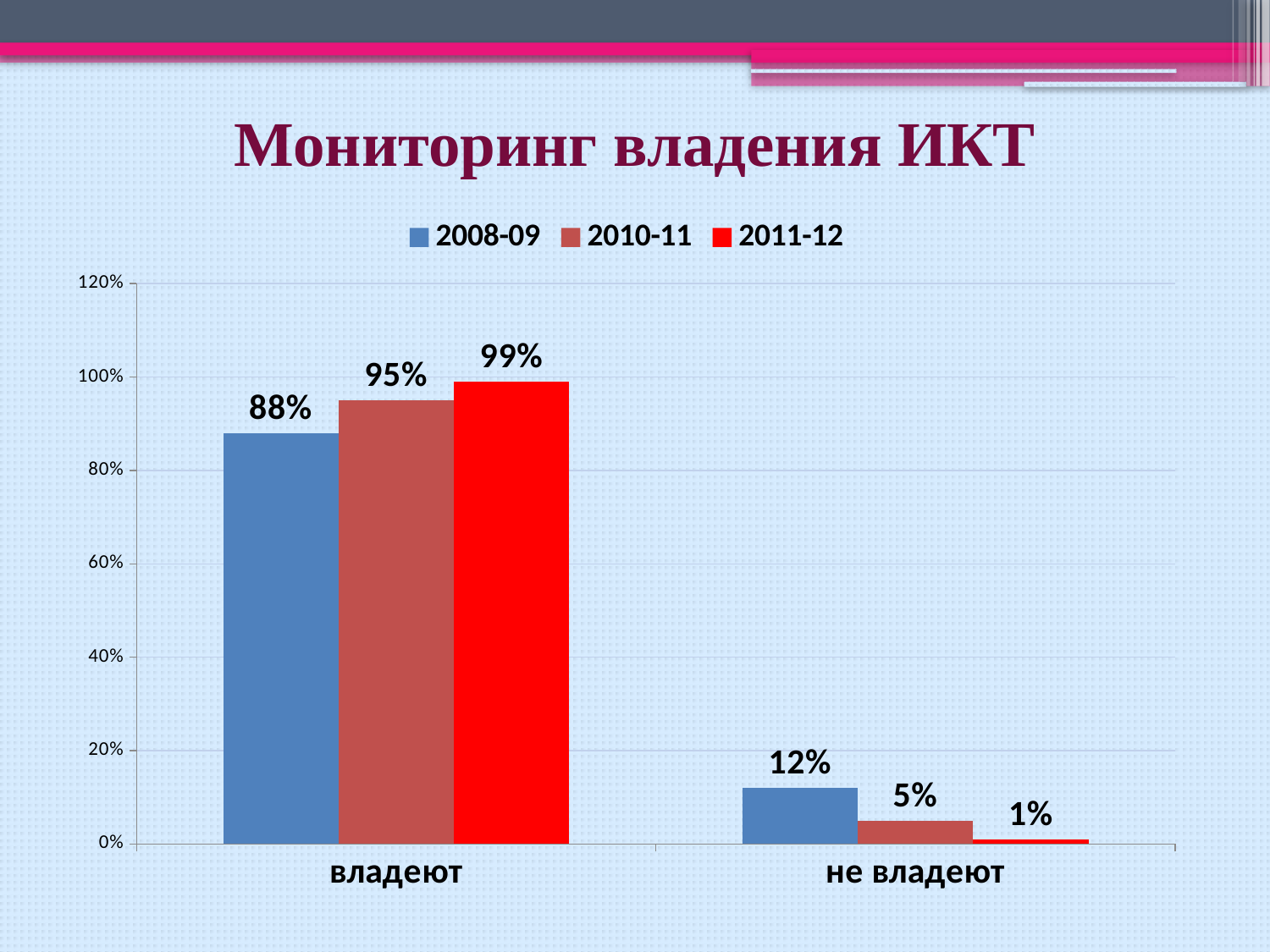
What is the value for 2008-09 in the владеют category? 88% What kind of chart is shown on the slide? bar chart How many series does the legend list? 3 Which series has the lowest value in the не владеют category? 2011-12 What is the difference between the 2011-12 and 2008-09 values in the владеют category? 11% How many categories are shown on the x axis? 2 What is the value for 2011-12 in the не владеют category? 1% What is the value for 2010-11 in the владеют category? 95% Which is larger: the 2008-09 value for не владеют or the 2010-11 value for не владеют? 2008-09 Which series has the highest value in the владеют category? 2011-12 What is the difference between the 2008-09 and 2010-11 values in the не владеют category? 7% What is the title of the slide? Мониторинг владения ИКТ